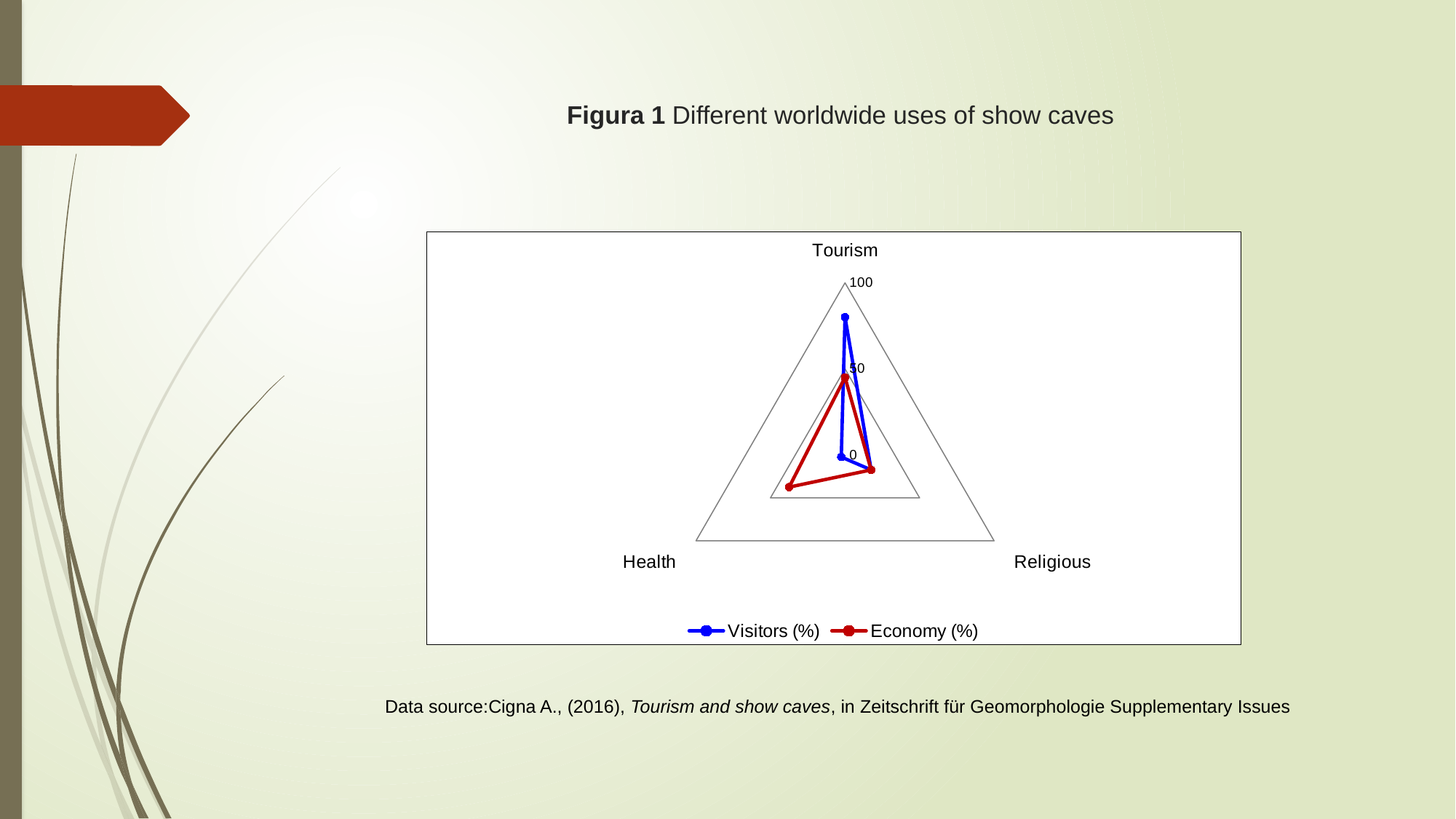
How many series does the legend list? 2 For the Visitors (%) series, which category has the lowest value? Health What is the title of the figure shown on the slide? Figura 1 Different worldwide uses of show caves What kind of chart is shown on the slide? Radar chart How many categories (axes) does the radar chart have? 3 Is the Economy (%) value for Health greater or less than 50? less What are the two series named in the legend? Visitors (%) and Economy (%) For Tourism, which series has the larger value, Visitors (%) or Economy (%)? Visitors (%) Is the Economy (%) value for Religious greater or less than 50? less For the Visitors (%) series, which category has the highest value? Tourism Is the Visitors (%) value for Health greater or less than 50? less